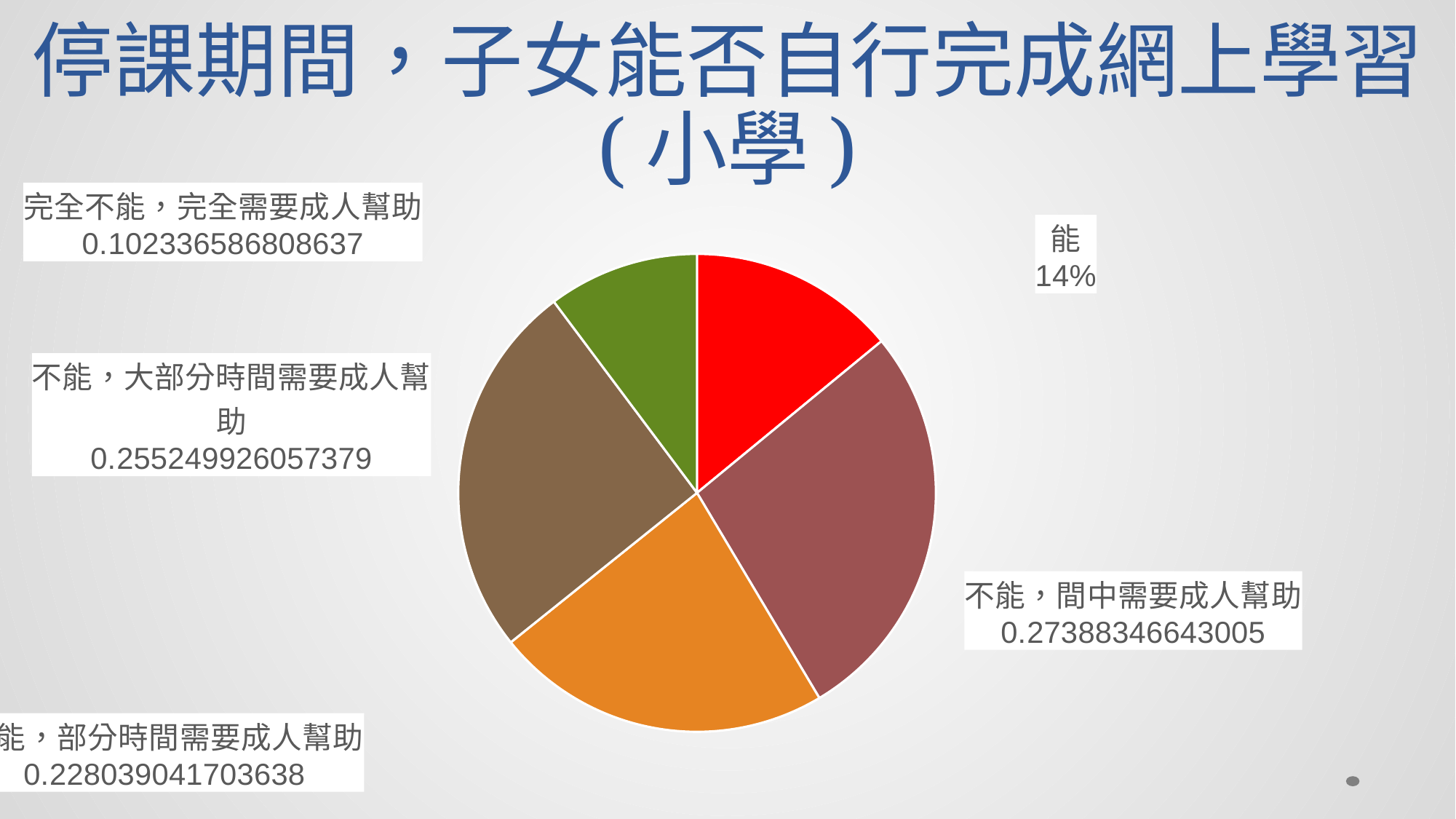
Which category has the smallest slice of the pie? 完全不能，完全需要成人幫助 Which category has the largest slice of the pie? 不能，間中需要成人幫助 What is the title of the chart on the slide? 停課期間，子女能否自行完成網上學習（小學） What colour is the slice labelled 能? red What value is shown for the slice labelled 不能，間中需要成人幫助? 0.27388346643005 Which is larger: the slice for 不能，大部分時間需要成人幫助 or the slice for 能，部分時間需要成人幫助? 不能，大部分時間需要成人幫助 What value is shown for the slice labelled 完全不能，完全需要成人幫助? 0.102336586808637 What value is shown for the slice labelled 能，部分時間需要成人幫助? 0.228039041703638 How many slices does the pie chart have? 5 What value is shown for the slice labelled 不能，大部分時間需要成人幫助? 0.255249926057379 What kind of chart is shown on the slide? pie chart What value is shown for the slice labelled 能? 14%